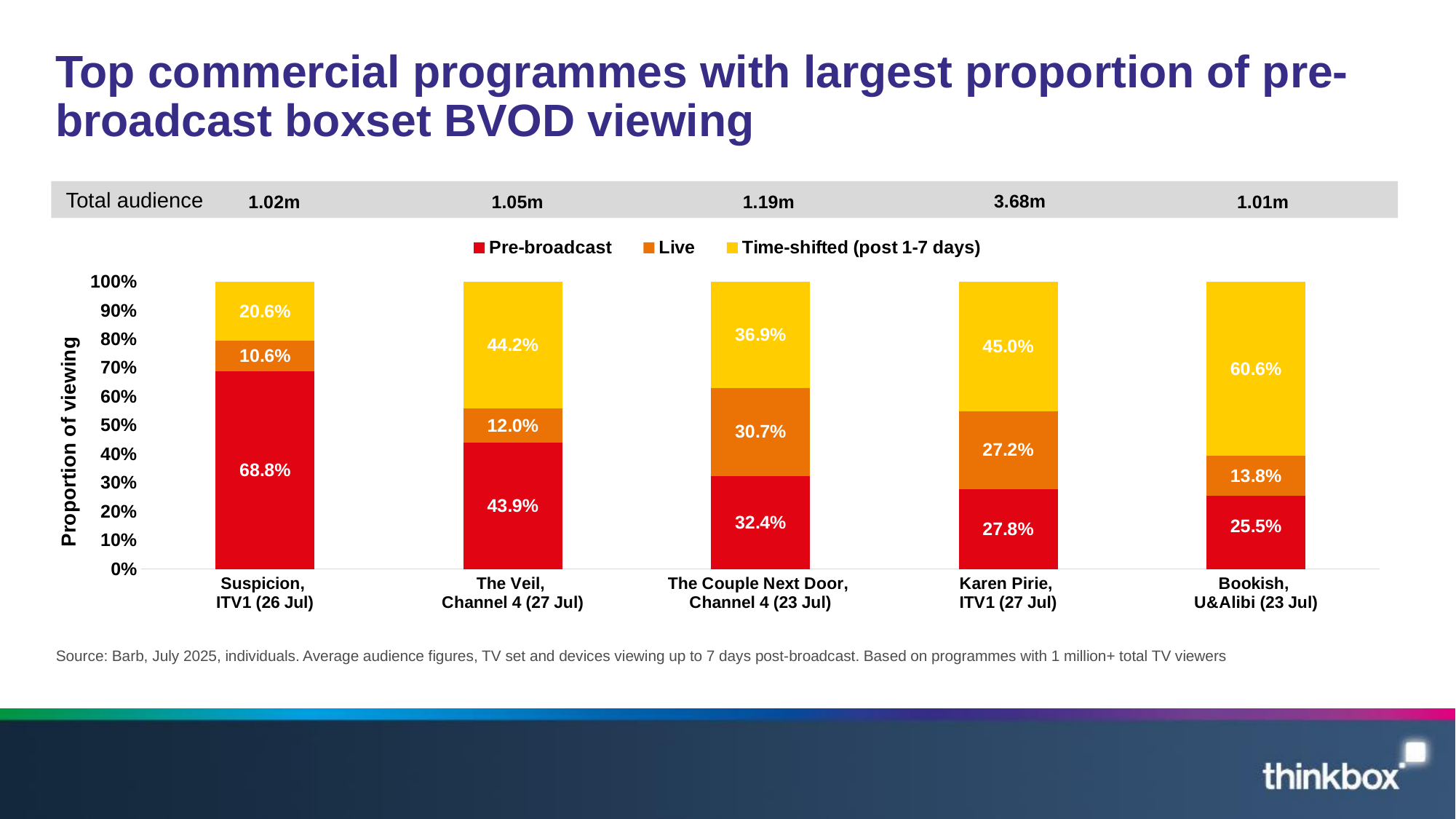
Which colour represents the Time-shifted (post 1-7 days) series? Yellow Which programme has the highest Pre-broadcast share? Suspicion, ITV1 (26 Jul) Which programme has the lowest Live share? Suspicion, ITV1 (26 Jul) What is the total audience shown for Karen Pirie, ITV1 (27 Jul)? 3.68m What is the Pre-broadcast share for Suspicion, ITV1 (26 Jul)? 68.8% What is the difference between the Pre-broadcast share for The Veil, Channel 4 (27 Jul) and The Couple Next Door, Channel 4 (23 Jul)? 11.5% How many programmes are shown on the x axis? 5 What is the Time-shifted (post 1-7 days) share for Bookish, U&Alibi (23 Jul)? 60.6% What is the Live share for Karen Pirie, ITV1 (27 Jul)? 27.2% Which is larger: the Live share for The Couple Next Door, Channel 4 (23 Jul) or the Live share for Karen Pirie, ITV1 (27 Jul)? The Couple Next Door, Channel 4 (23 Jul) What kind of chart is shown on the slide? Stacked bar chart How many series does the legend list? 3